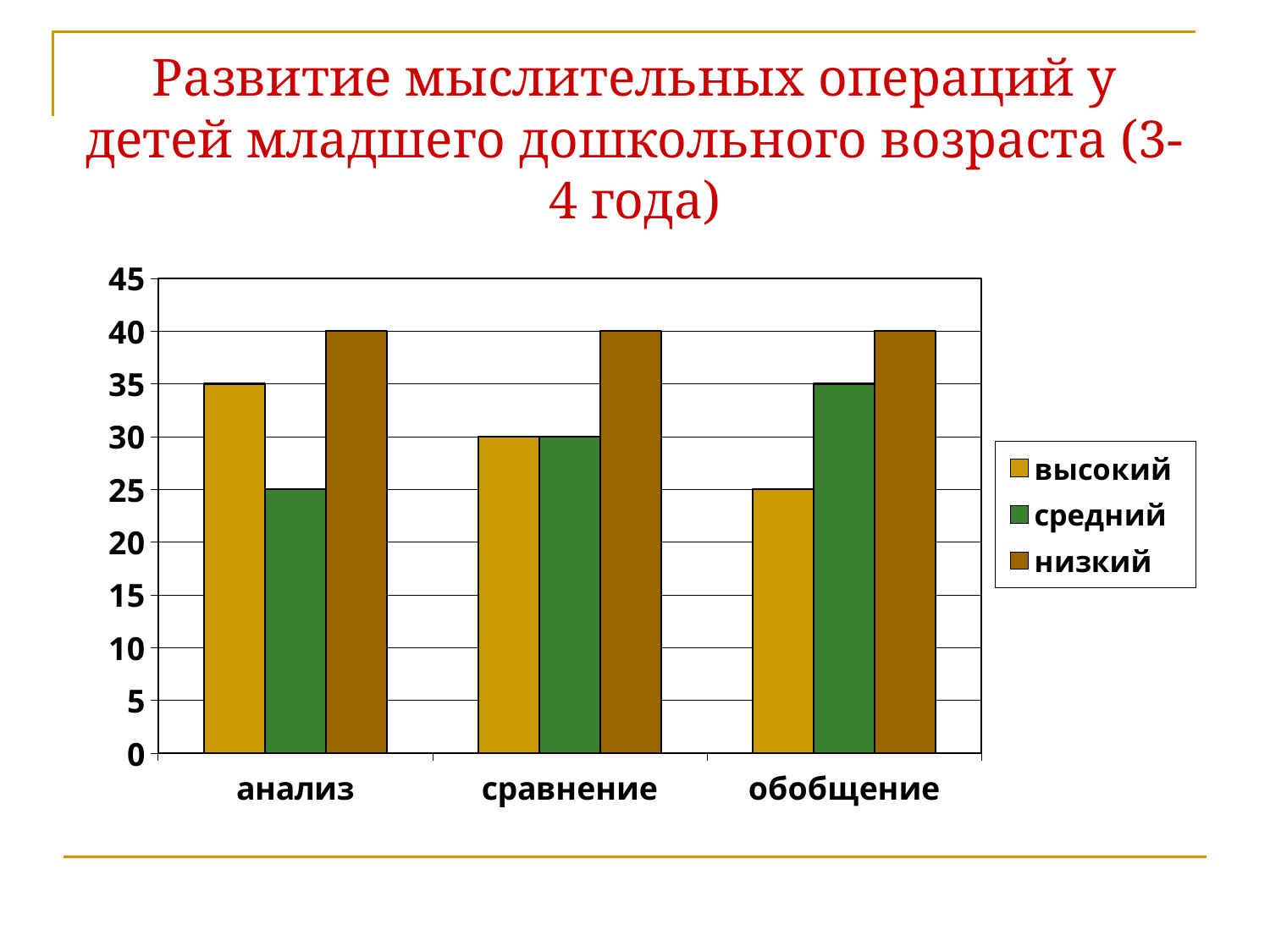
Which category has the highest value for средний? обобщение What is the difference between the низкий and высокий values in the обобщение category? 15 Which category has the lowest value for высокий? обобщение How many series does the legend list? 3 What is the value for средний in the обобщение category? 35 What is the value for средний in the анализ category? 25 Which is larger in the анализ category, высокий or средний? высокий What is the value for высокий in the анализ category? 35 Does the value for высокий rise or fall across the categories from анализ to обобщение? fall How many categories are shown on the x axis? 3 What kind of chart is shown on the slide? bar chart What is the value for низкий in the сравнение category? 40